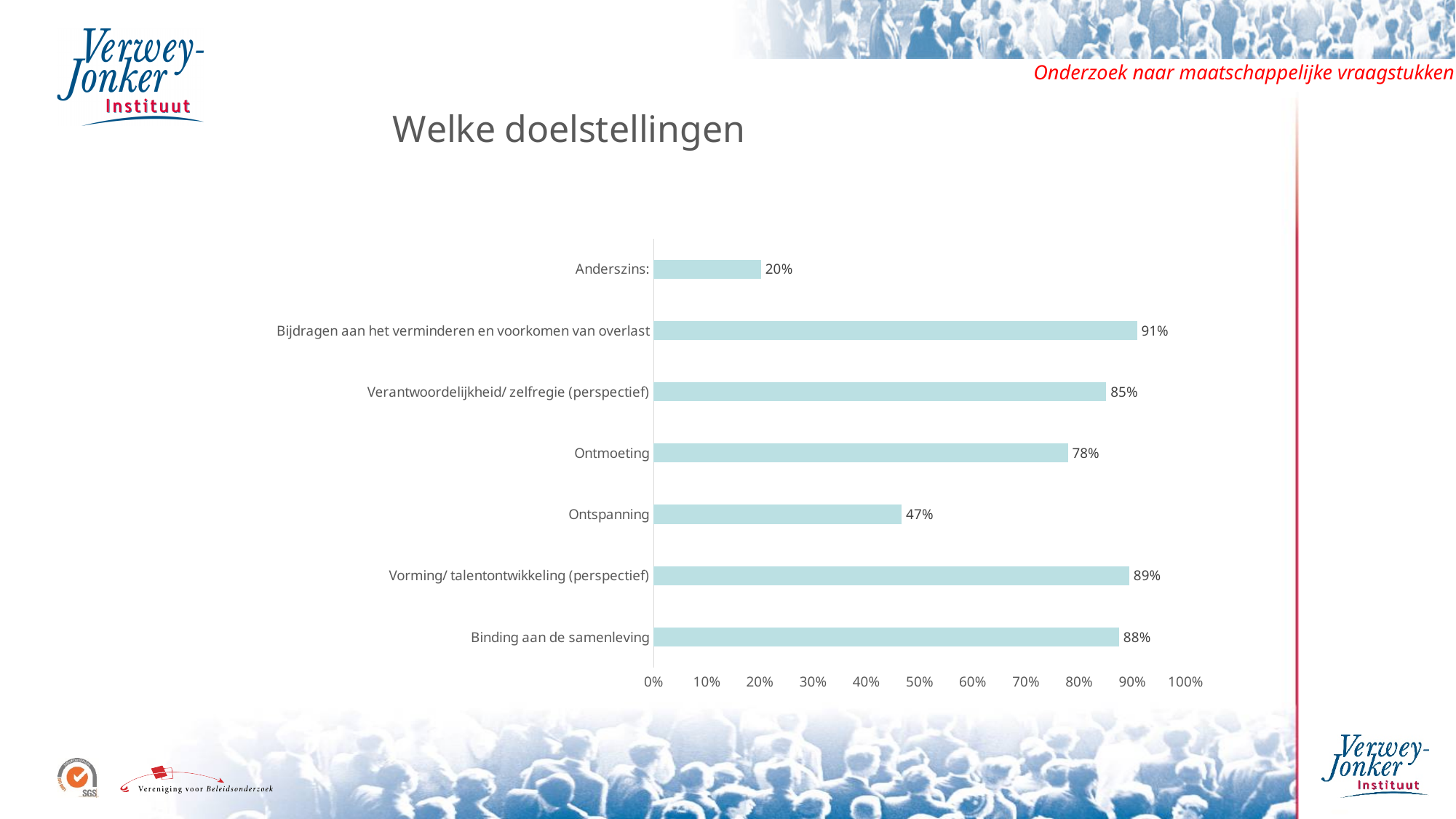
What kind of chart is shown on the slide? Bar chart What is the value for Vorming/ talentontwikkeling (perspectief)? 89% Is the value for Binding aan de samenleving greater or less than 80%? greater What is the highest value shown on the x axis? 100% What is the value for Anderszins? 20% What is the difference between the values for Verantwoordelijkheid/ zelfregie (perspectief) and Ontspanning? 38% What is the title of the slide? Welke doelstellingen Which category has the highest value? Bijdragen aan het verminderen en voorkomen van overlast What is the value for Ontmoeting? 78% How many categories are shown in the chart? 7 Which category has the lowest value? Anderszins Which is larger, the value for Ontmoeting or the value for Ontspanning? Ontmoeting